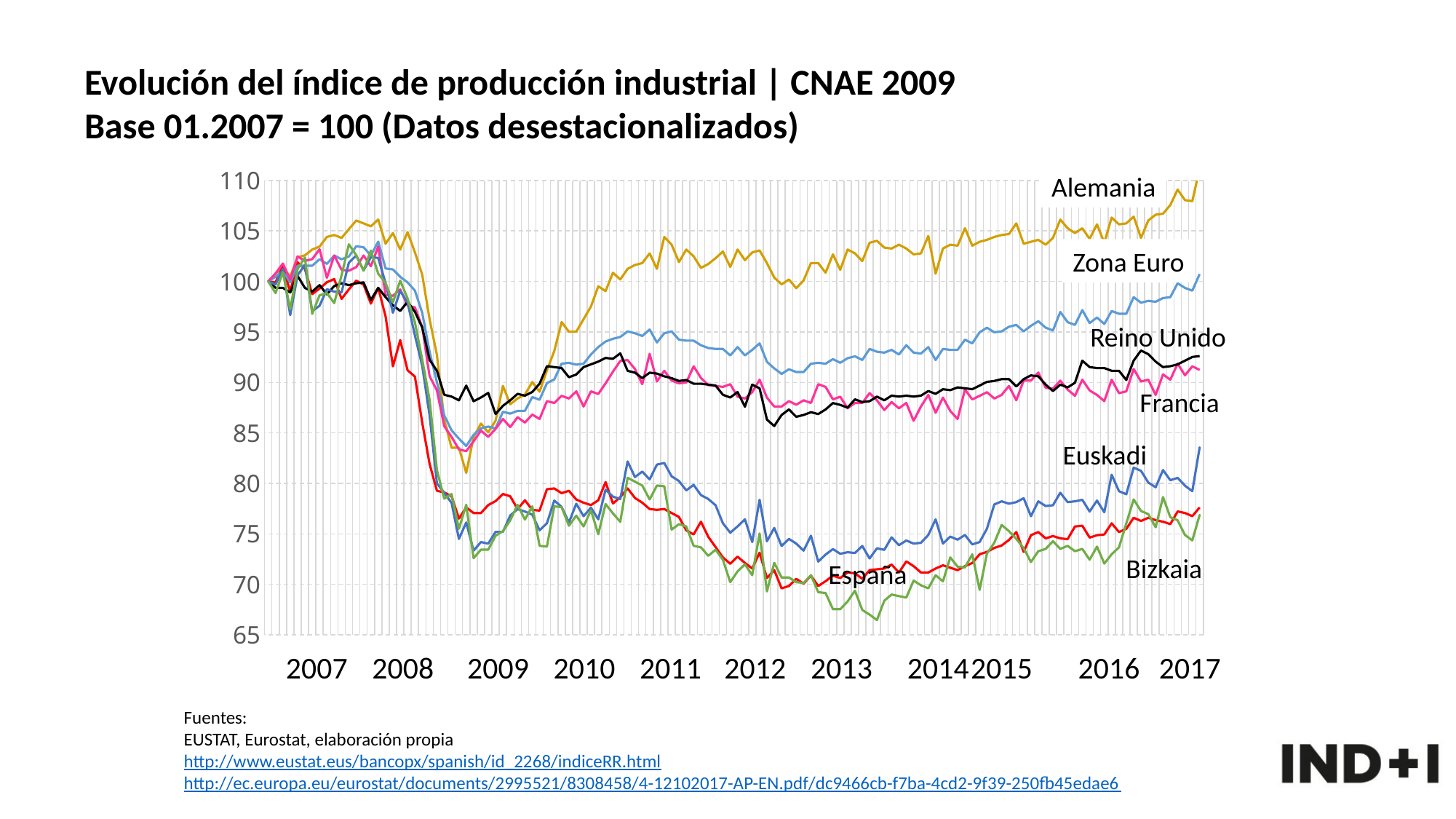
Is the value for Alemania at the end of 2017 greater or less than 105? greater Is the value for Zona Euro at the end of 2017 greater or less than 95? greater Is the value for España at the start of 2013 greater or less than 75? less How many series (countries/regions) are plotted on the chart? 7 What kind of chart is shown on the slide? line chart What base period is used for the index according to the chart title? 01.2007 = 100 Which series has the highest value at the end of the chart in 2017? Alemania Does the Alemania series rise or fall between 2013 and 2017? rise Which series is higher at the end of 2017, Reino Unido or Euskadi? Reino Unido Which series is higher at the end of 2017, Zona Euro or Francia? Zona Euro Which series has the lowest value at the end of the chart in 2017? Bizkaia